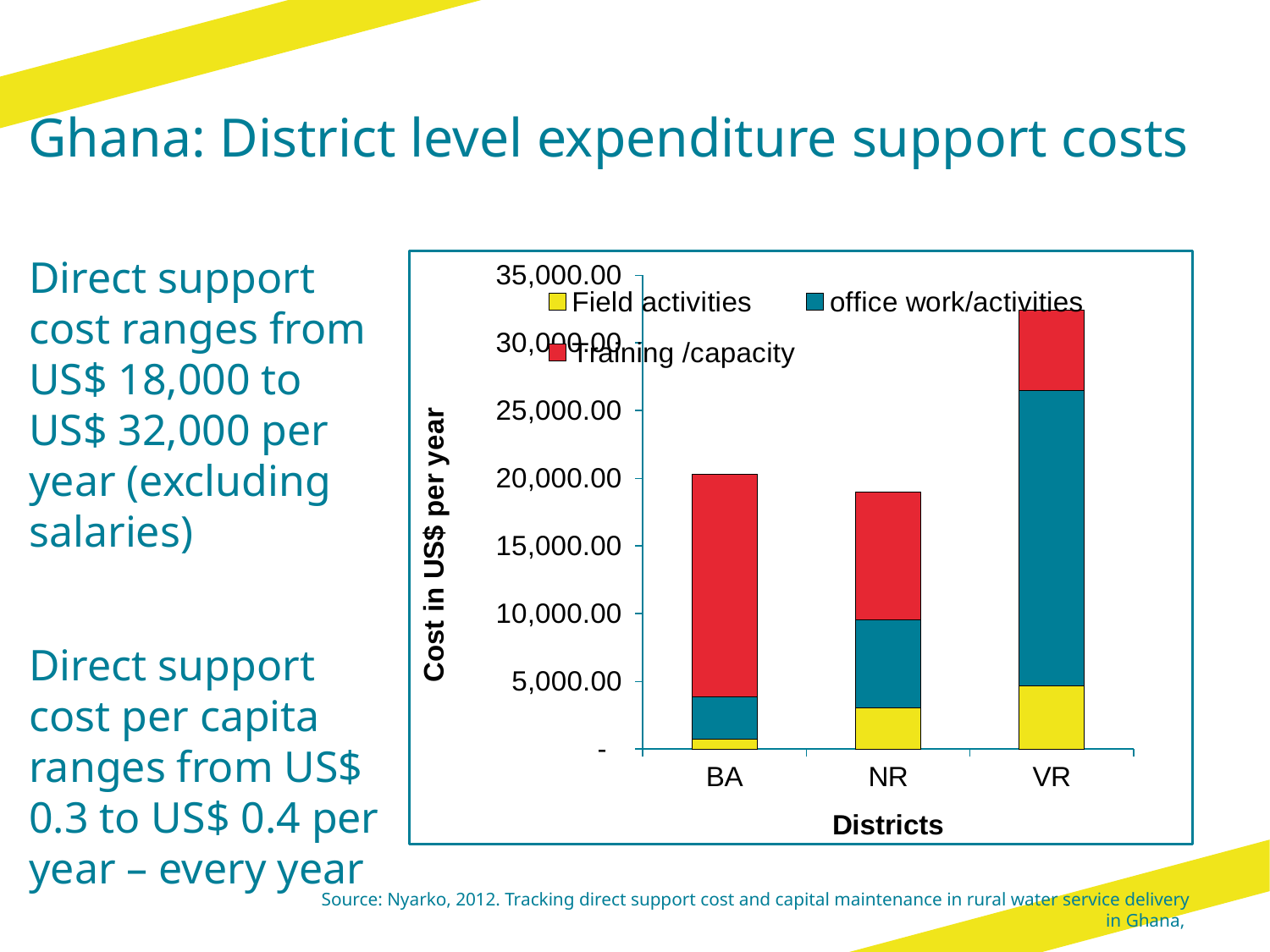
What kind of chart is shown on the slide? Stacked bar chart Is the total cost for NR greater or less than 20,000.00? less Which district has the largest office work/activities segment? VR How many series does the chart legend list? 3 Which district has the lowest total cost bar? NR Is the total cost for VR greater or less than 30,000.00? greater What is the title of the chart's y axis? Cost in US$ per year How many districts are shown on the x axis of the chart? 3 Which district has the largest Training /capacity segment? BA Which is larger, the office work/activities segment for VR or for BA? VR Which district has the highest total cost bar? VR Which district has the smallest Field activities segment? BA